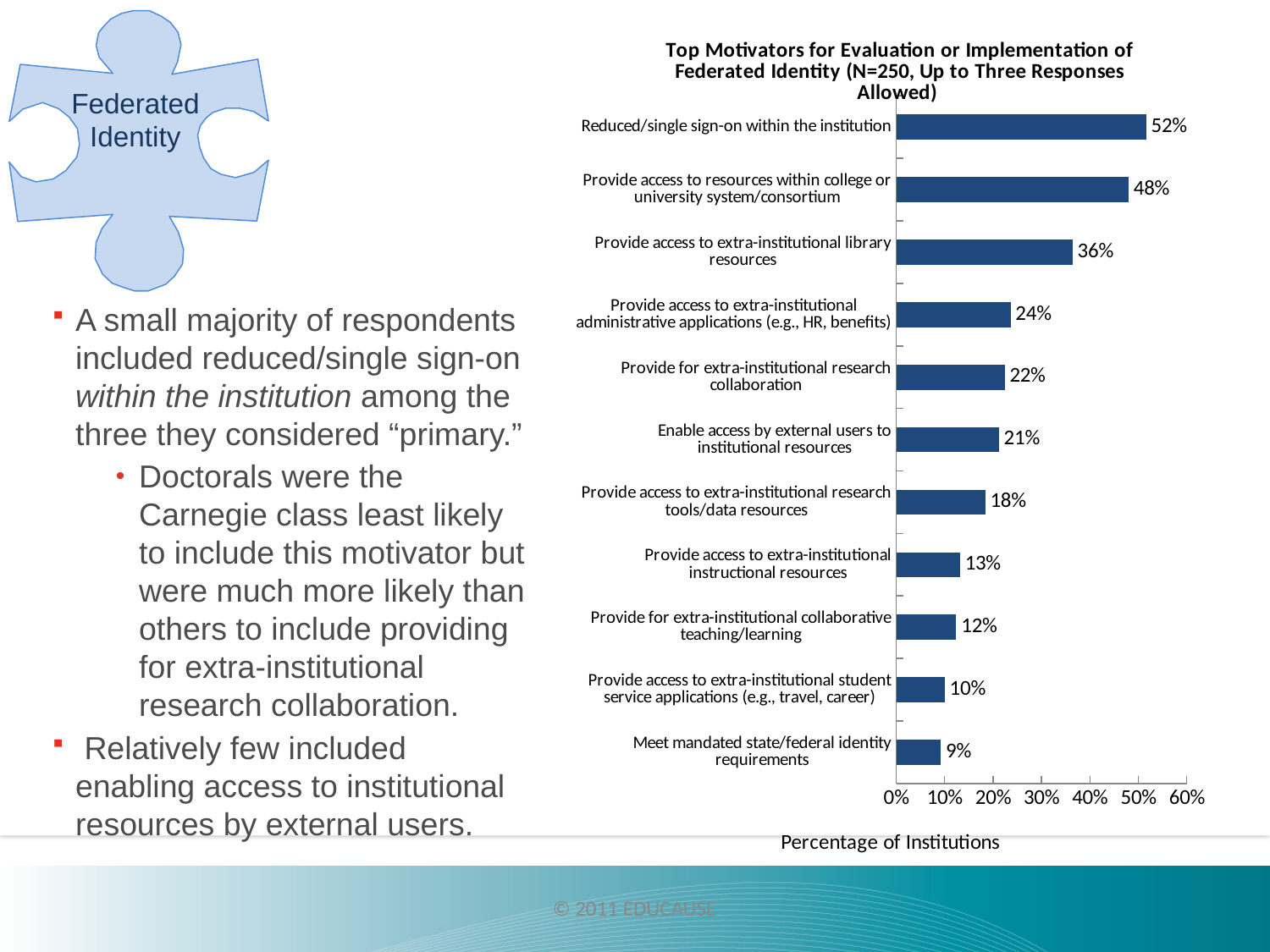
Which motivator has the highest percentage of institutions? Reduced/single sign-on within the institution What type of chart is shown on the slide? Bar chart What is the label of the horizontal axis of the chart? Percentage of Institutions What is the value for 'Provide access to extra-institutional library resources'? 36% What is the difference in percentage points between 'Provide access to extra-institutional research tools/data resources' and 'Provide access to extra-institutional instructional resources'? 5 percentage points What percentage of institutions cited reduced/single sign-on within the institution as a top motivator? 52% What is the difference in percentage points between 'Reduced/single sign-on within the institution' and 'Provide access to resources within college or university system/consortium'? 4 percentage points Is the value for 'Provide access to extra-institutional administrative applications (e.g., HR, benefits)' greater or less than 20%? greater Which motivator has the lowest percentage of institutions? Meet mandated state/federal identity requirements Which is larger: the value for 'Provide for extra-institutional research collaboration' or 'Enable access by external users to institutional resources'? Provide for extra-institutional research collaboration How many motivators are shown in the chart? 11 What percentage of institutions cited meeting mandated state/federal identity requirements? 9%